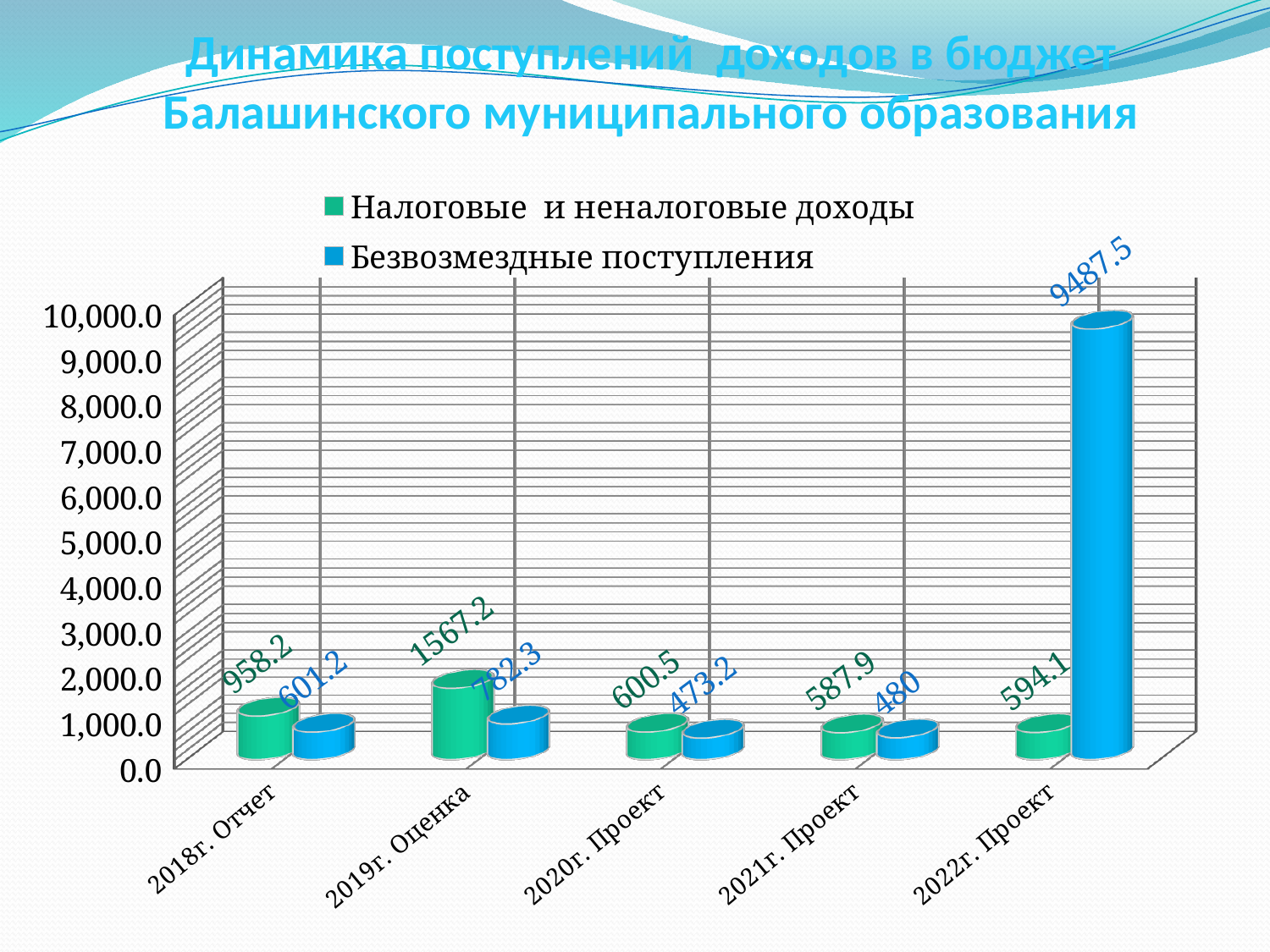
What is the value of Налоговые и неналоговые доходы for 2019г. Оценка? 1567.2 How many series does the legend list? 2 Which category has the lowest value for Безвозмездные поступления? 2020г. Проект Which category has the highest value for Налоговые и неналоговые доходы? 2019г. Оценка What is the value of Безвозмездные поступления for 2022г. Проект? 9487.5 What is the value of Безвозмездные поступления for 2021г. Проект? 480 For 2022г. Проект, which series has the larger value: Налоговые и неналоговые доходы or Безвозмездные поступления? Безвозмездные поступления What kind of chart is shown on the slide? Bar chart What is the total of Налоговые и неналоговые доходы and Безвозмездные поступления for 2020г. Проект? 1073.7 What is the difference between Налоговые и неналоговые доходы and Безвозмездные поступления for 2018г. Отчет? 357 How many categories are shown on the x axis? 5 What is the value of Налоговые и неналоговые доходы for 2018г. Отчет? 958.2